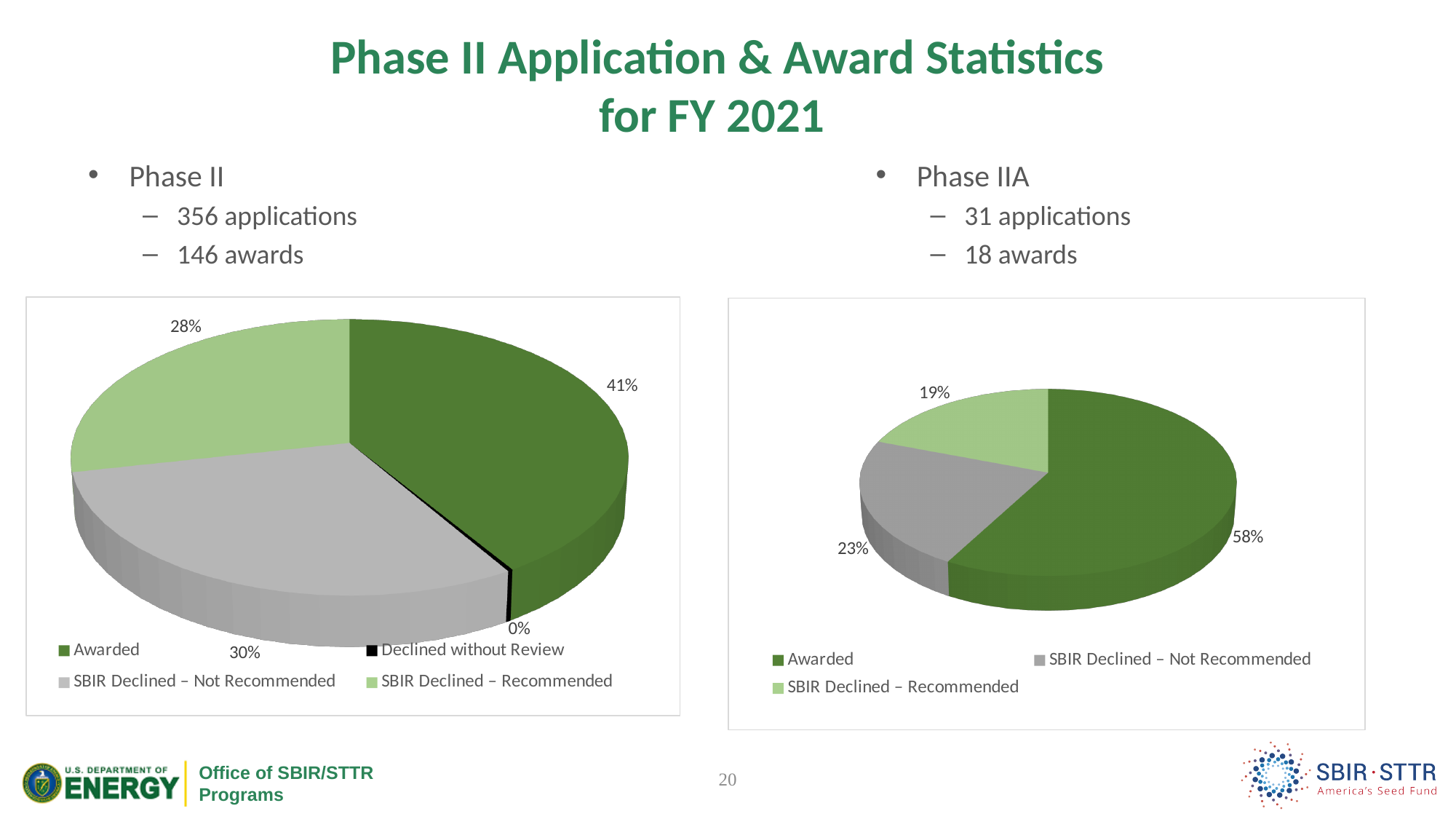
In the left pie chart (Phase II), what percentage is labelled for SBIR Declined – Not Recommended? 30% In the left pie chart (Phase II), what percentage is shown for Declined without Review? 0% In the right pie chart (Phase IIA), what is the difference in percentage points between Awarded and SBIR Declined – Recommended? 39 In the left pie chart (Phase II), what percentage is shown for SBIR Declined – Recommended? 28% In the left pie chart (Phase II), what share of the pie is Awarded? 41% What type of chart is used on the right side of the slide (Phase IIA)? Pie chart In the left pie chart (Phase II), how many categories does the legend list? 4 In the right pie chart (Phase IIA), what share of the pie is Awarded? 58% In the left pie chart (Phase II), which category has the largest share? Awarded In the right pie chart (Phase IIA), what percentage is shown for SBIR Declined – Not Recommended? 23% In the right pie chart (Phase IIA), which is larger, SBIR Declined – Not Recommended or SBIR Declined – Recommended? SBIR Declined – Not Recommended In the left pie chart (Phase II), which category has the smallest share? Declined without Review